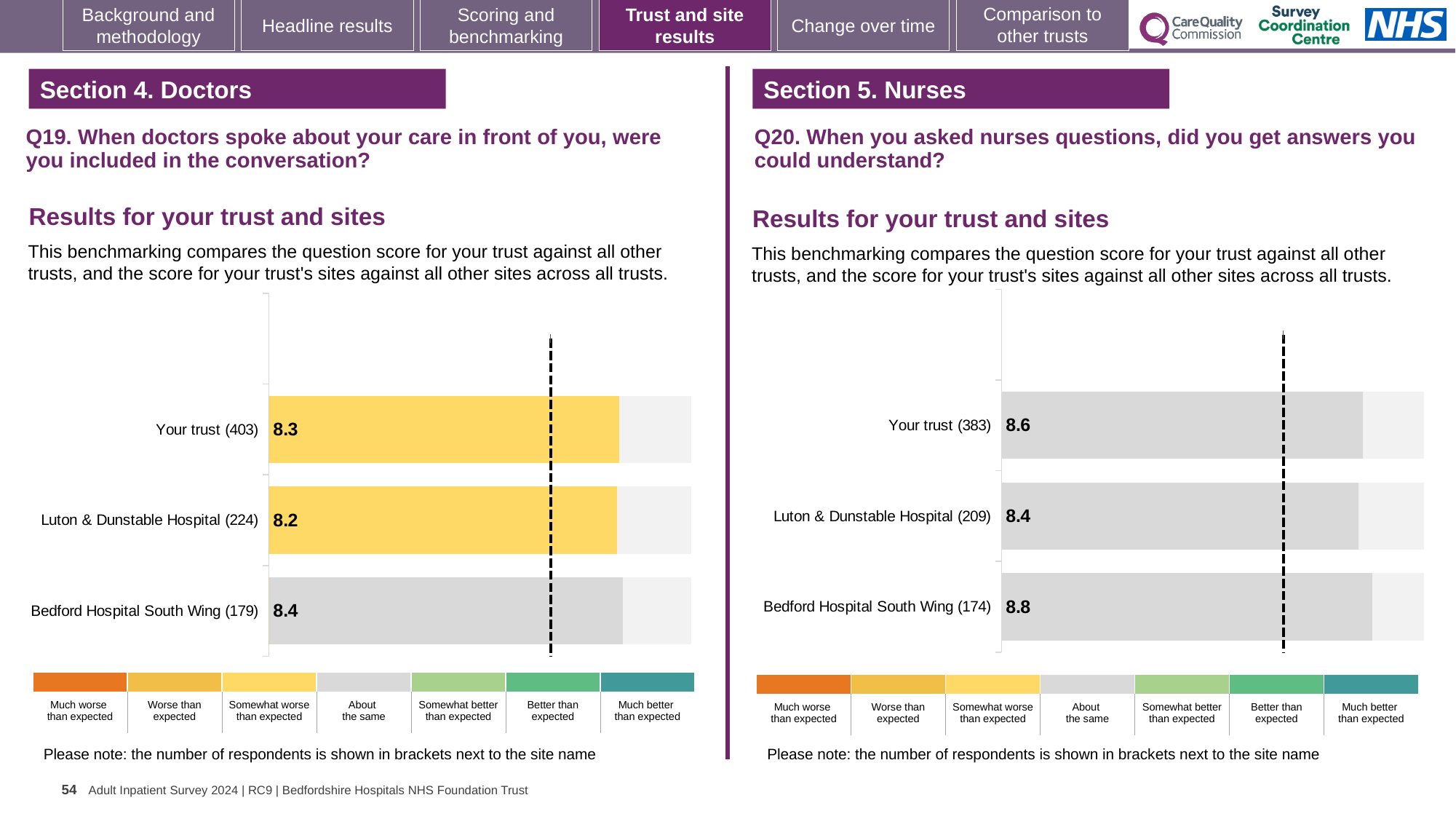
How many sites or trusts are plotted in the Q19 chart on the left? 3 In the Q19 chart on the left, what is the difference between the scores for Bedford Hospital South Wing (179) and Luton & Dunstable Hospital (224)? 0.2 In the Q19 chart on the left, what is the score for Your trust (403)? 8.3 In the Q20 chart on the right, what is the difference between the scores for Bedford Hospital South Wing (174) and Your trust (383)? 0.2 In the Q19 chart on the left, what is the score for Luton & Dunstable Hospital (224)? 8.2 What kind of chart is used for the Q20 results on the right? Bar chart In the Q20 chart on the right, what is the score for Bedford Hospital South Wing (174)? 8.8 In the Q20 chart on the right, which is larger: the score for Your trust (383) or Luton & Dunstable Hospital (209)? Your trust (383) In the Q20 chart on the right, which site or trust has the lowest score? Luton & Dunstable Hospital (209) In the Q20 chart on the right, what is the score for Your trust (383)? 8.6 In the Q19 chart on the left, which site or trust has the highest score? Bedford Hospital South Wing (179) In the Q19 chart on the left, which site or trust has the lowest score? Luton & Dunstable Hospital (224)